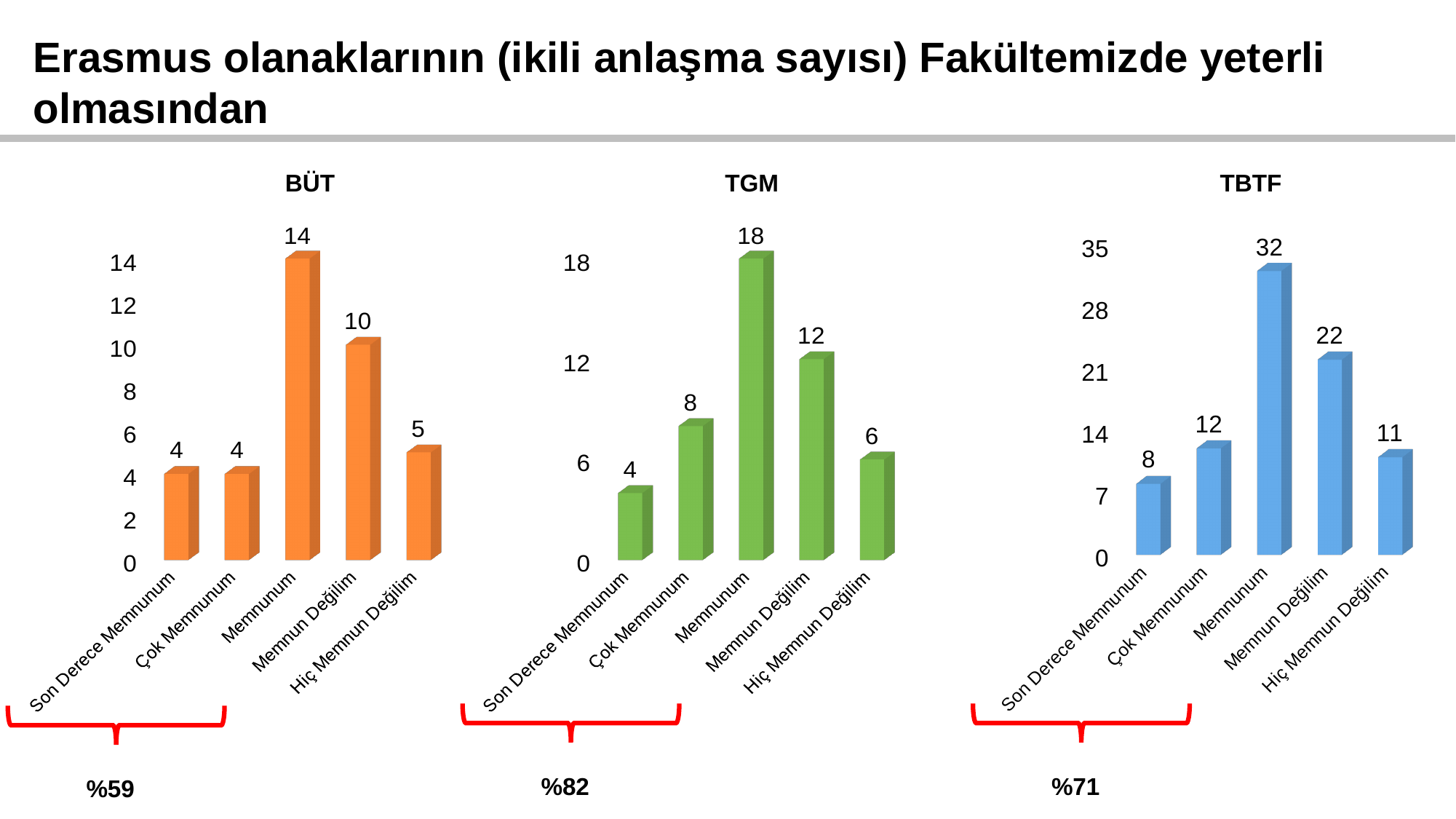
How many charts are on the slide? 3 In the TGM chart, what is the value for Çok Memnunum? 8 In the BÜT chart, what is the value for Memnunum? 14 What kind of chart is the TGM chart? bar chart In the BÜT chart, what is the difference between the values for Memnunum and Memnun Değilim? 4 In the TGM chart, which is larger, the value for Memnun Değilim or the value for Hiç Memnun Değilim? Memnun Değilim What colour are the bars in the TBTF chart? blue How many categories does the BÜT chart show? 5 In the TBTF chart, what is the value for Memnun Değilim? 22 In the TGM chart, which category has the lowest value? Son Derece Memnunum In the TBTF chart, which category has the highest value? Memnunum In the TBTF chart, what is the difference between the values for Memnunum and Hiç Memnun Değilim? 21